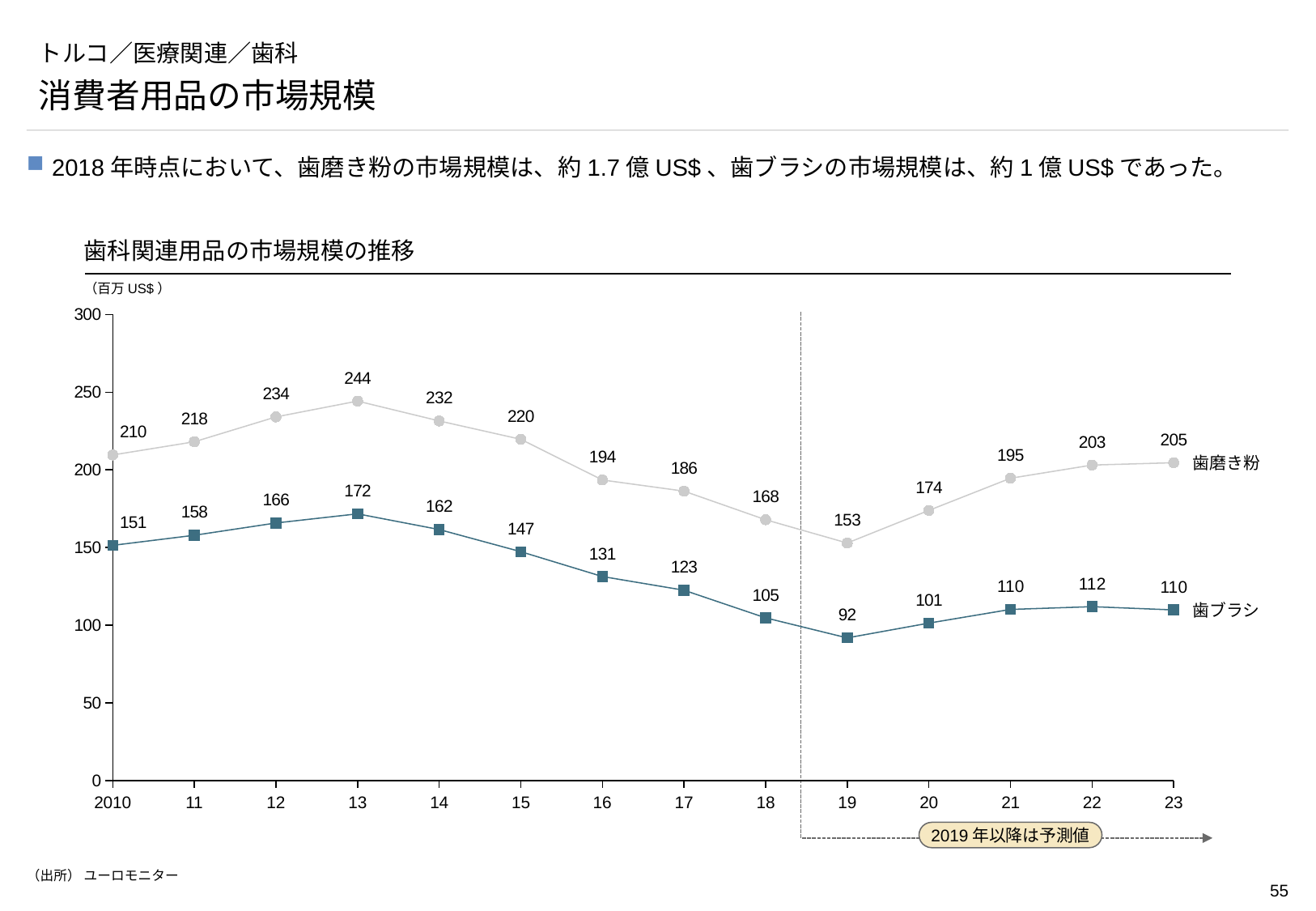
What kind of chart is shown on the slide? line chart How many years are plotted on the x axis? 14 What is the value for 歯ブラシ in 2018? 105 In which year is the 歯磨き粉 series at its highest? 2013 How many series are shown in the chart? 2 What is the difference between 歯磨き粉 and 歯ブラシ in 2018? 63 What is the title of the chart? 歯科関連用品の市場規模の推移 Does the 歯ブラシ series rise or fall from 2013 to 2019? fall Is the value for 歯磨き粉 in 2019 greater or less than 150? greater In which year is the 歯ブラシ series at its lowest? 2019 What is the value for 歯磨き粉 in 2013? 244 Which is larger in 2023, the value for 歯磨き粉 or the value for 歯ブラシ? 歯磨き粉